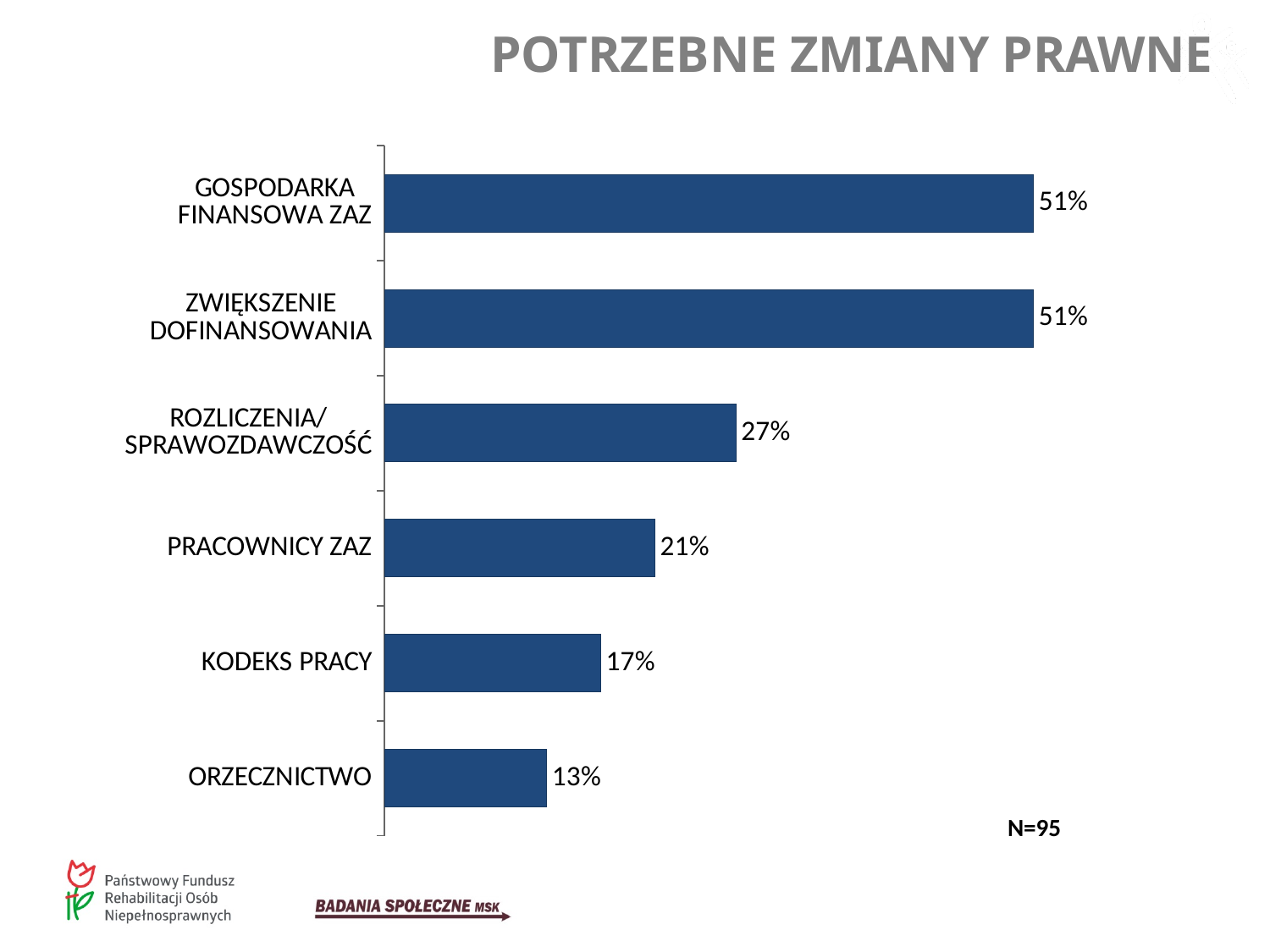
What is the value for KODEKS PRACY? 17% What kind of chart is shown on the slide? Bar chart Which is larger, the value for KODEKS PRACY or the value for ORZECZNICTWO? KODEKS PRACY What is the value for ORZECZNICTWO? 13% What is the value for GOSPODARKA FINANSOWA ZAZ? 51% What is the value for ROZLICZENIA/ SPRAWOZDAWCZOŚĆ? 27% Which category has the lowest value? ORZECZNICTWO What is the title of the slide? POTRZEBNE ZMIANY PRAWNE How many categories are shown in the chart? 6 What is the difference between the values for PRACOWNICY ZAZ and KODEKS PRACY? 4% What is the difference between the values for ZWIĘKSZENIE DOFINANSOWANIA and ROZLICZENIA/ SPRAWOZDAWCZOŚĆ? 24% What is the value for PRACOWNICY ZAZ? 21%